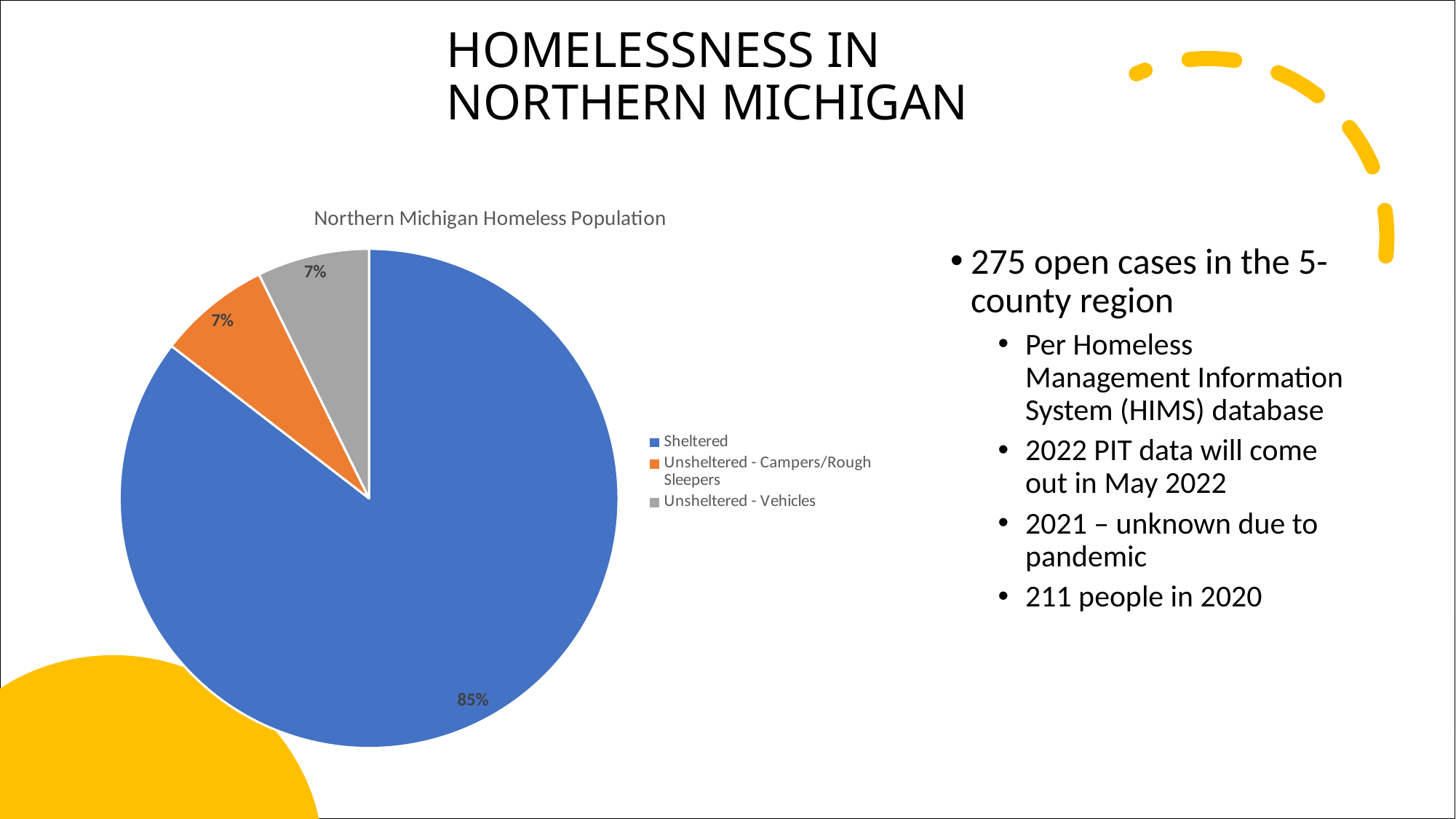
What is the title of the chart? Northern Michigan Homeless Population What share of the pie is Unsheltered - Campers/Rough Sleepers? 7% Which category has the largest slice of the pie? Sheltered What kind of chart is shown on the slide? pie chart What colour is the Sheltered slice? blue What share of the pie is Sheltered? 85% How many entries does the legend list? 3 What is the difference between the Sheltered share and the Unsheltered - Vehicles share? 78% What share of the pie is Unsheltered - Vehicles? 7% What is the combined share of the two Unsheltered categories? 14% How many categories does the pie chart show? 3 Which is larger, the Sheltered slice or the Unsheltered - Campers/Rough Sleepers slice? Sheltered